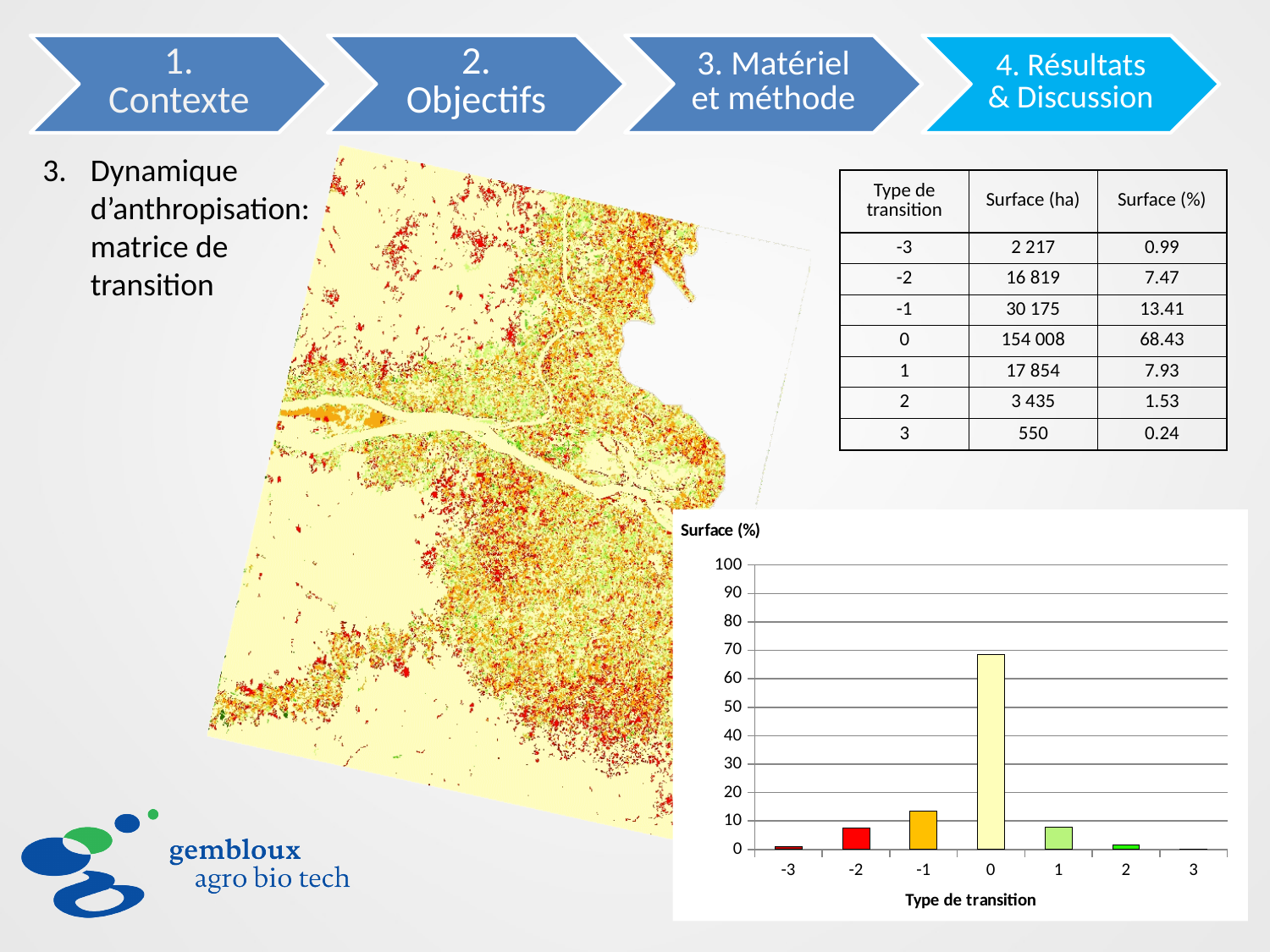
Which has the larger Surface (%): transition type -2 or transition type 2? -2 Which transition type has the lowest Surface (%) in the chart? 3 Is the value for transition type 0 greater or less than 60? greater What kind of chart is shown on the slide? bar chart Is the value for transition type -1 greater or less than 20? less Is the value for transition type -2 greater or less than 10? less What label is shown above the y axis of the chart? Surface (%) How do the bar values change moving from -3 to 3 along the x axis? rise then fall What is the title of the x axis of the chart? Type de transition Which has the larger Surface (%): transition type -1 or transition type 1? -1 How many transition types (bars) are plotted on the x axis of the chart? 7 Which transition type has the highest Surface (%) in the chart? 0